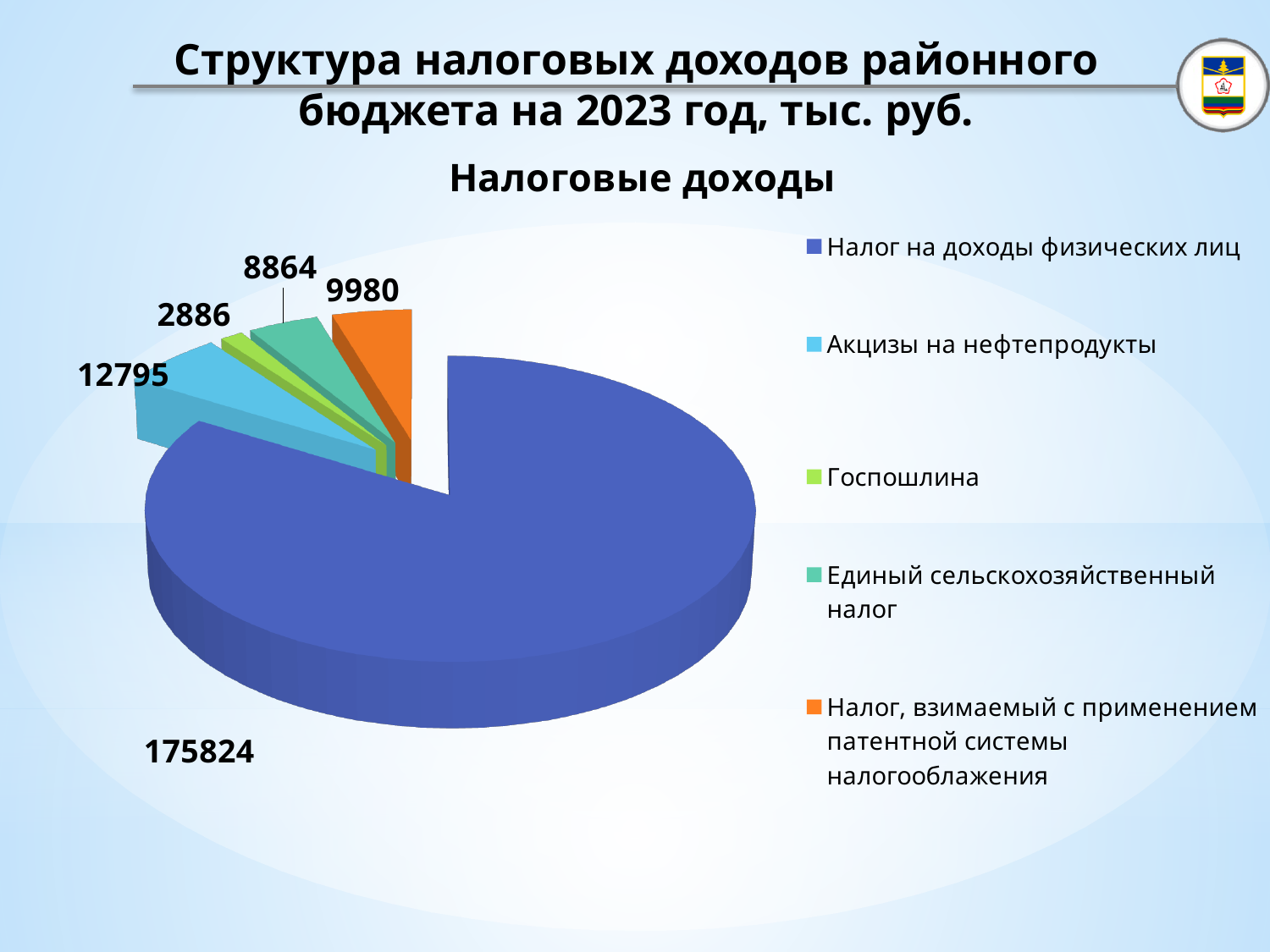
What is the value for Налог, взимаемый с применением патентной системы налогообложения? 9980 Which is larger: Налог, взимаемый с применением патентной системы налогообложения or Единый сельскохозяйственный налог? Налог, взимаемый с применением патентной системы налогообложения What is the difference between Акцизы на нефтепродукты and Единый сельскохозяйственный налог? 3931 What is the title of the chart? Налоговые доходы What is the value for Акцизы на нефтепродукты? 12795 Which category has the smallest slice of the pie? Госпошлина What is the value for Единый сельскохозяйственный налог? 8864 Which category has the largest slice of the pie? Налог на доходы физических лиц What is the value for Госпошлина? 2886 What is the value for Налог на доходы физических лиц? 175824 How many categories does the pie chart show? 5 What type of chart is shown on the slide? Pie chart